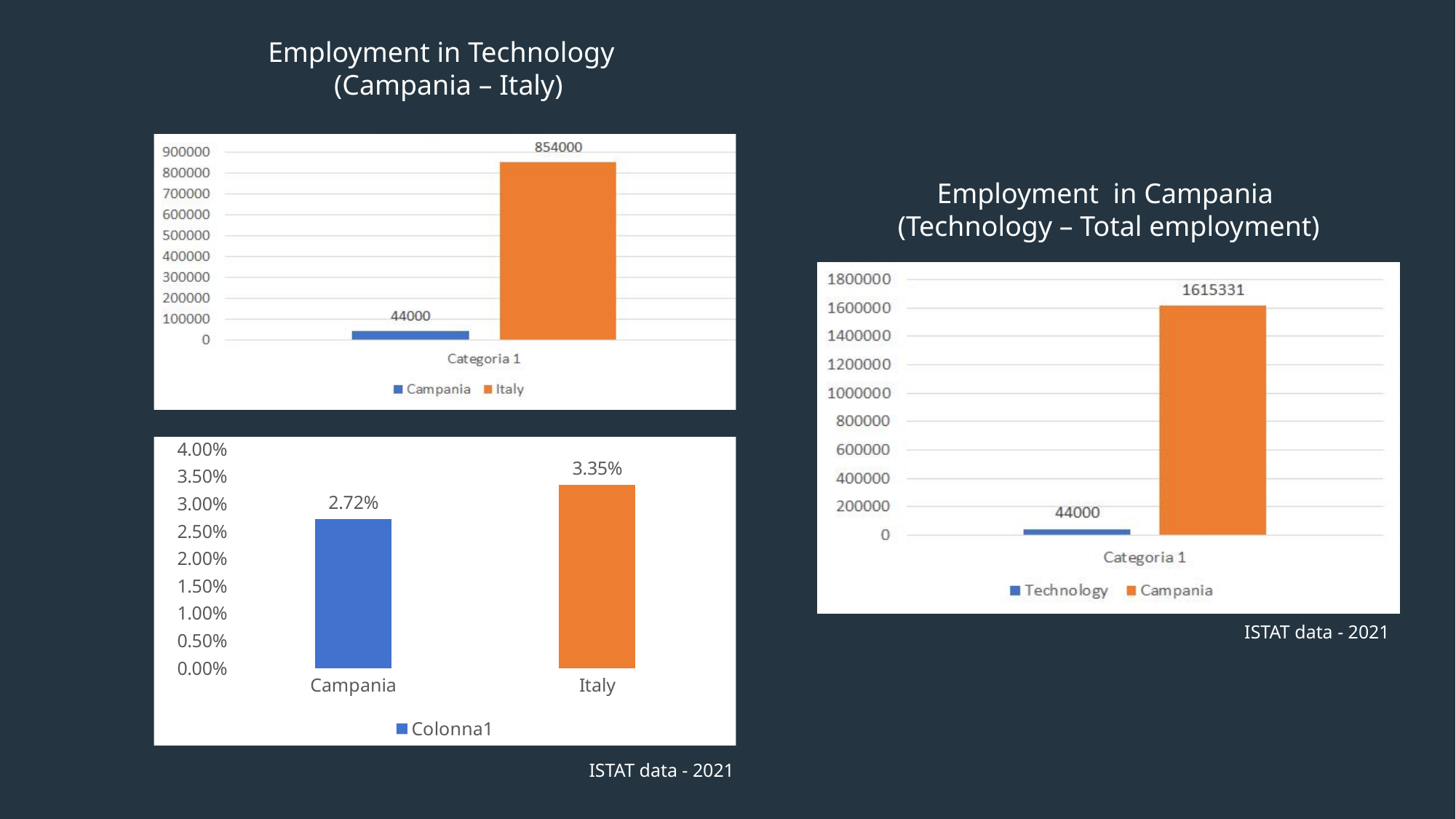
In the top-left chart titled 'Employment in Technology (Campania – Italy)', what is the value for Campania? 44000 In the bottom-left percentage chart, what is the legend entry? Colonna1 In the right chart titled 'Employment in Campania (Technology – Total employment)', what is the value for Campania? 1615331 In the top-left chart titled 'Employment in Technology (Campania – Italy)', how many series does the legend list? 2 What kind of chart is the right chart titled 'Employment in Campania (Technology – Total employment)'? bar chart In the bottom-left percentage chart, what is the value for Italy? 3.35% In the bottom-left percentage chart, which category has the higher value, Campania or Italy? Italy In the top-left chart titled 'Employment in Technology (Campania – Italy)', what is the value for Italy? 854000 In the right chart titled 'Employment in Campania (Technology – Total employment)', what is the value for Technology? 44000 In the bottom-left percentage chart, what is the value for Campania? 2.72% In the top-left chart titled 'Employment in Technology (Campania – Italy)', what is the difference between the Italy and Campania values? 810000 In the bottom-left percentage chart, what is the difference between the Italy and Campania values? 0.63%